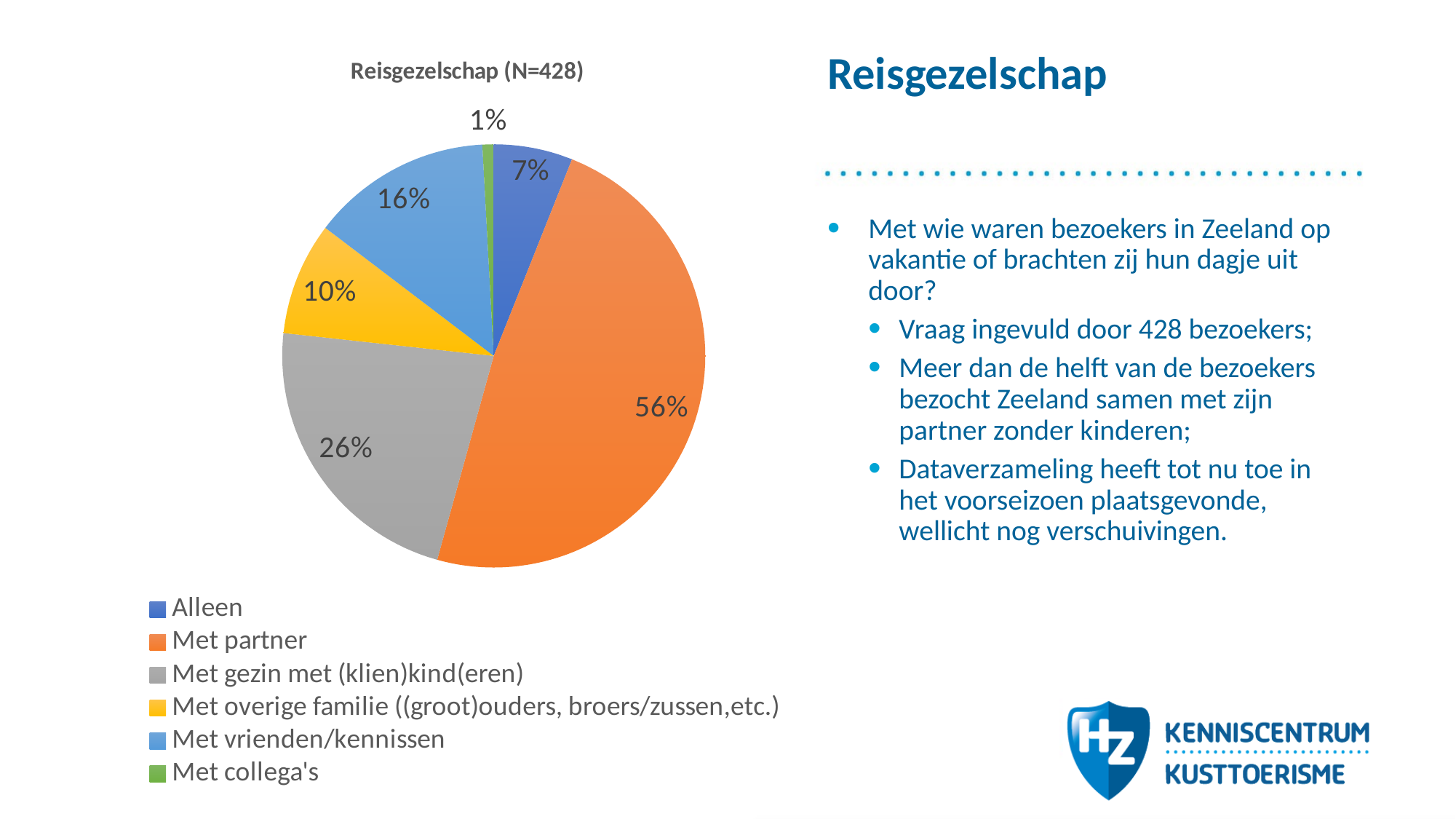
Which category has the smallest slice of the pie? Met collega's What share of the pie is 'Met partner'? 56% What share of the pie is 'Met vrienden/kennissen'? 16% How many categories does the legend list? 6 What share of the pie is 'Met gezin met (klien)kind(eren)'? 26% What share of the pie is 'Met collega's'? 1% What is the title of the chart? Reisgezelschap (N=428) What is the difference in percentage points between 'Met partner' and 'Met gezin met (klien)kind(eren)'? 30 What share of the pie is 'Alleen'? 7% What kind of chart is shown on the slide? pie chart Which is larger: 'Met vrienden/kennissen' or 'Met overige familie ((groot)ouders, broers/zussen,etc.)'? Met vrienden/kennissen Which category has the largest slice of the pie? Met partner